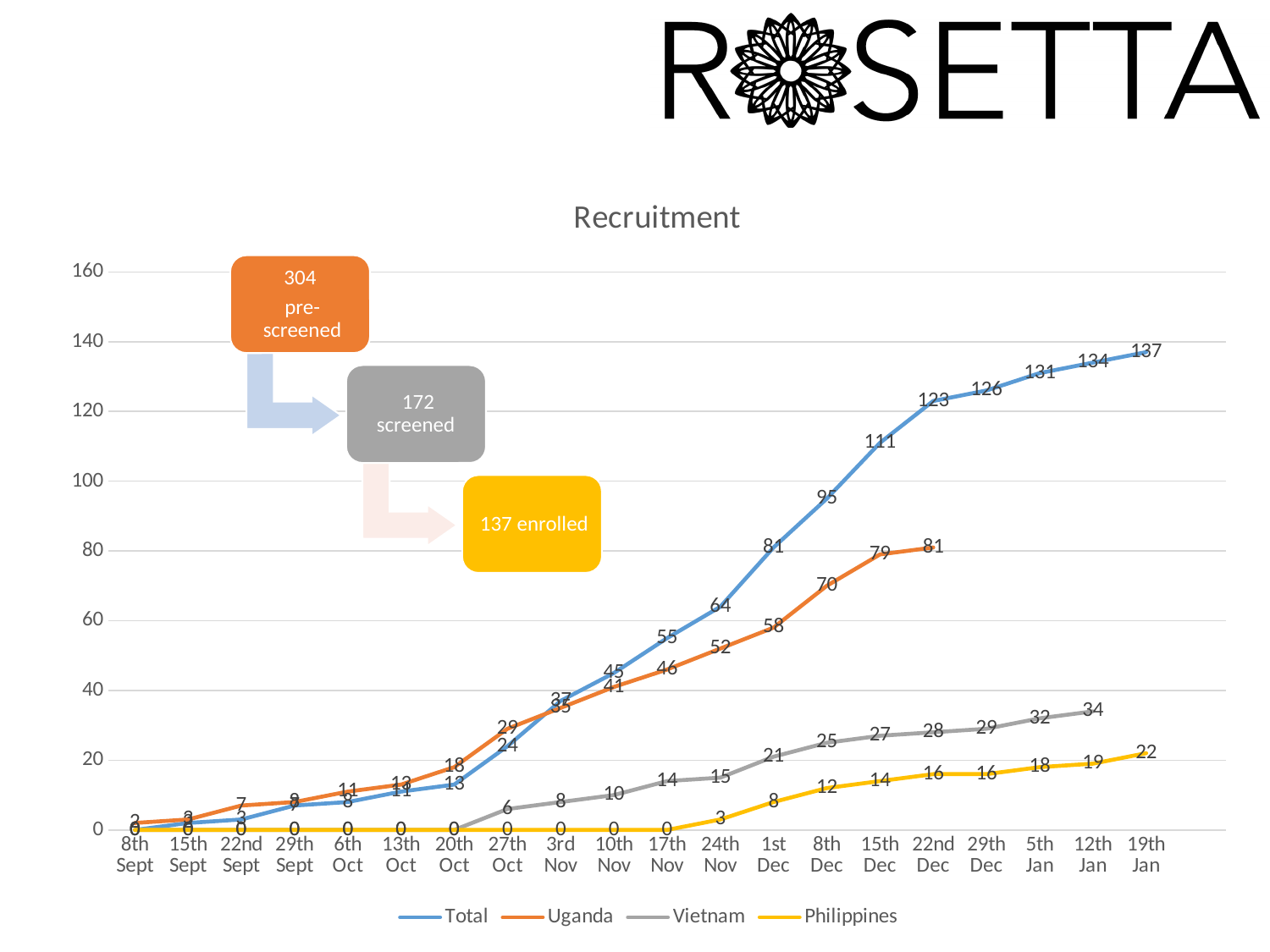
What is the Uganda value on 22nd Dec? 81 How many series does the legend list? 4 How many dates are shown along the x axis? 20 Which series has the highest value on 22nd Dec? Total What is the difference between the Total value and the Uganda value on 8th Dec? 25 On 8th Dec, which is larger: the Vietnam value or the Philippines value? Vietnam What is the Total value on 19th Jan? 137 What is the title of the chart? Recruitment What is the Vietnam value on 12th Jan? 34 Does the Total line rise or fall from 8th Sept to 19th Jan? rise What is the Philippines value on 19th Jan? 22 What kind of chart is shown on the slide? line chart